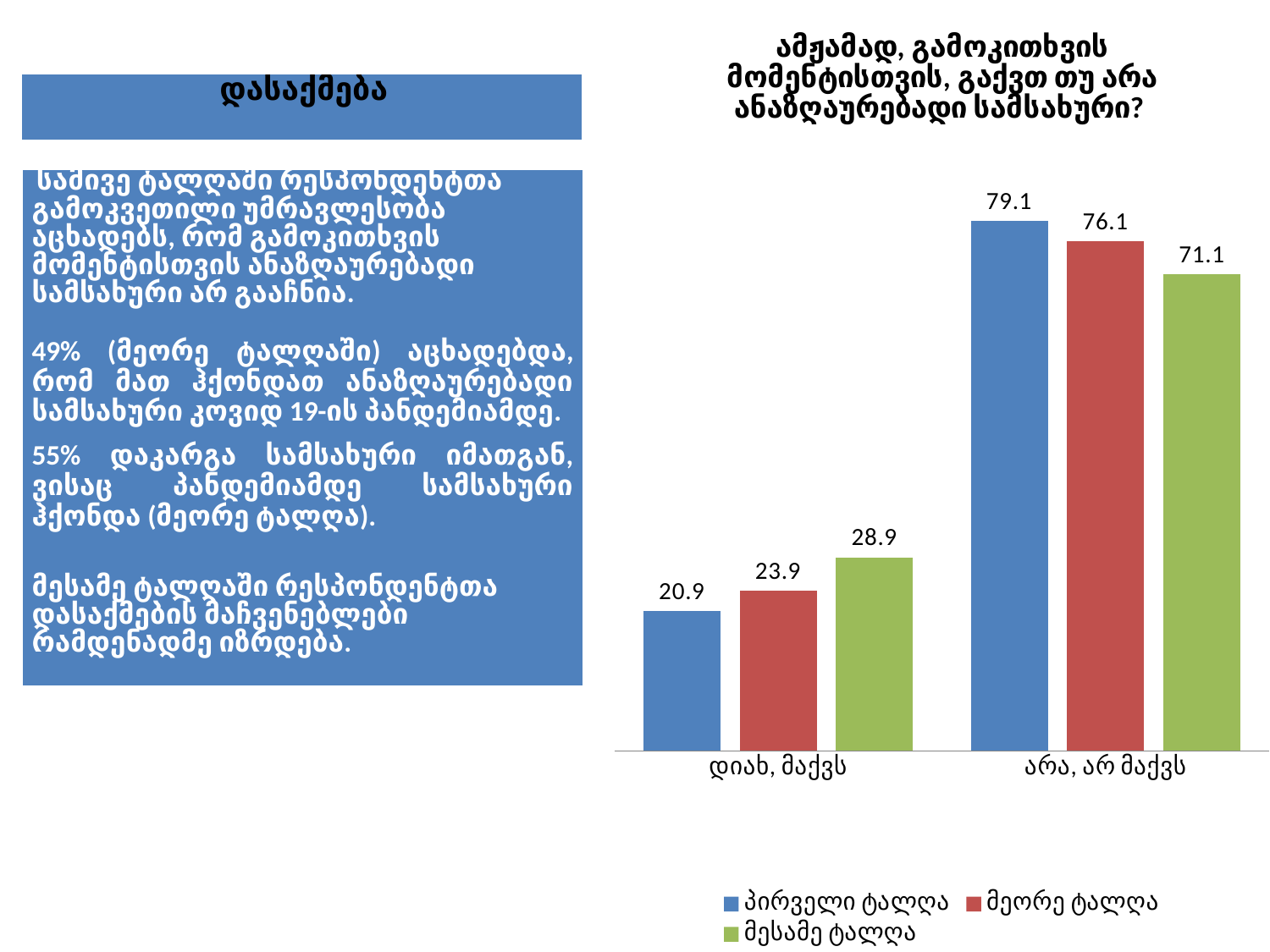
Which series has the highest value in the "არა, არ მაქვს" category? პირველი ტალღა What is the value for "მესამე ტალღა" in the "არა, არ მაქვს" category? 71.1 What is the value for "მესამე ტალღა" in the "დიახ, მაქვს" category? 28.9 What is the difference between the "პირველი ტალღა" and "მესამე ტალღა" values in the "არა, არ მაქვს" category? 8.0 Which is larger: the "მეორე ტალღა" value for "დიახ, მაქვს" or the "მეორე ტალღა" value for "არა, არ მაქვს"? არა, არ მაქვს What type of chart is shown on the slide? bar chart What is the value for "მეორე ტალღა" in the "არა, არ მაქვს" category? 76.1 How many series does the legend list? 3 What is the value for "პირველი ტალღა" in the "დიახ, მაქვს" category? 20.9 What is the difference between the "მესამე ტალღა" and "მეორე ტალღა" values in the "დიახ, მაქვს" category? 5.0 Which series has the lowest value in the "დიახ, მაქვს" category? პირველი ტალღა How many categories are shown on the x axis? 2